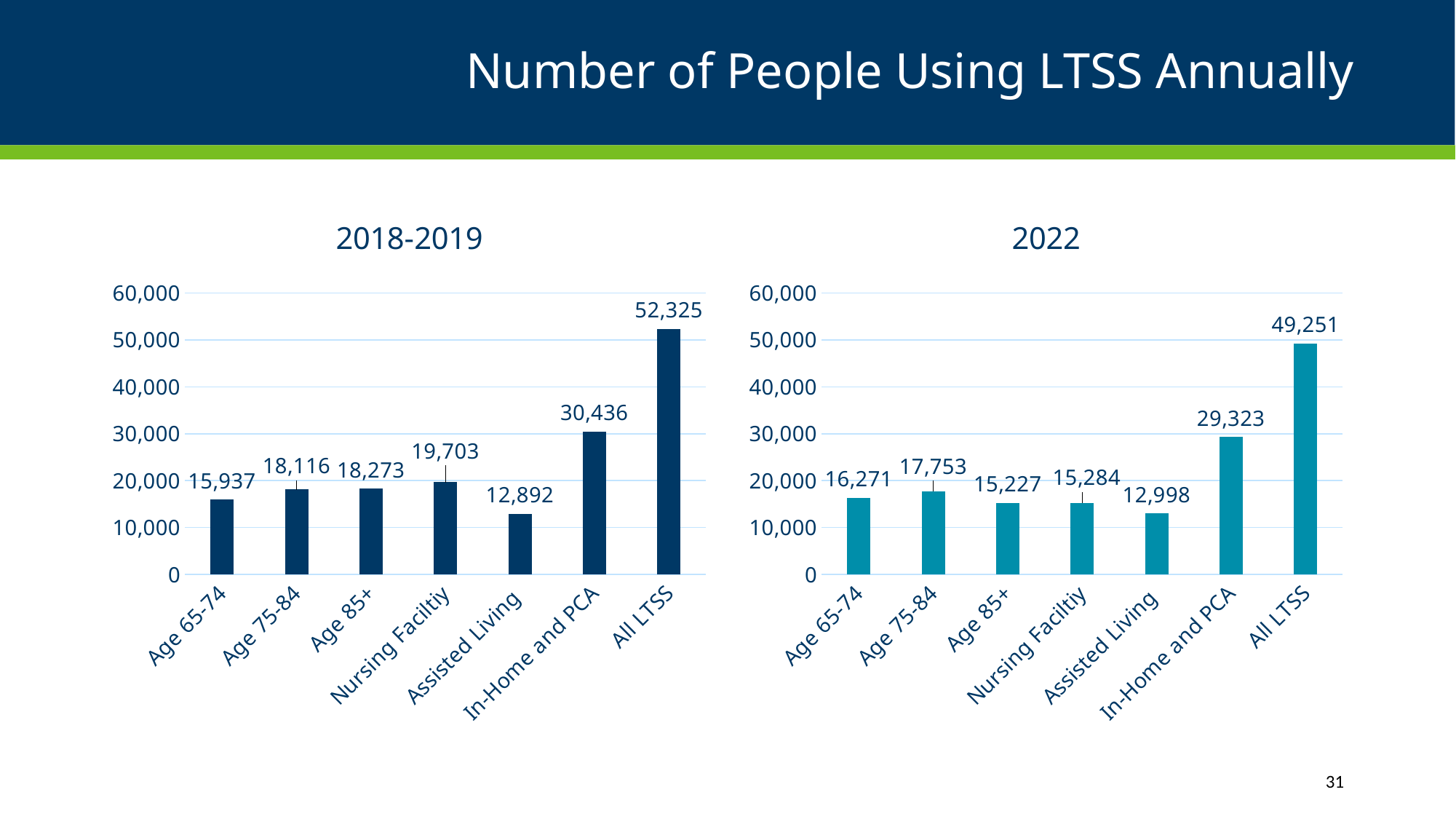
In the 2022 chart, what is the difference between Age 75-84 and Age 65-74? 1,482 How many categories are shown in the 2022 chart? 7 In the 2022 chart, which category has the highest value? All LTSS In the 2018-2019 chart, which category has the lowest value? Assisted Living In the 2022 chart, is the value for Assisted Living greater or less than 20,000? less In the 2018-2019 chart, what is the difference between All LTSS and In-Home and PCA? 21,889 In the 2022 chart, what is the value for Age 85+? 15,227 In the 2022 chart, what is the value for In-Home and PCA? 29,323 What kind of chart is the 2018-2019 chart? bar chart What is the title of the chart on the right side of the slide? 2022 In the 2018-2019 chart, what is the value for All LTSS? 52,325 In the 2018-2019 chart, which is larger, Nursing Faciltiy or Age 85+? Nursing Faciltiy